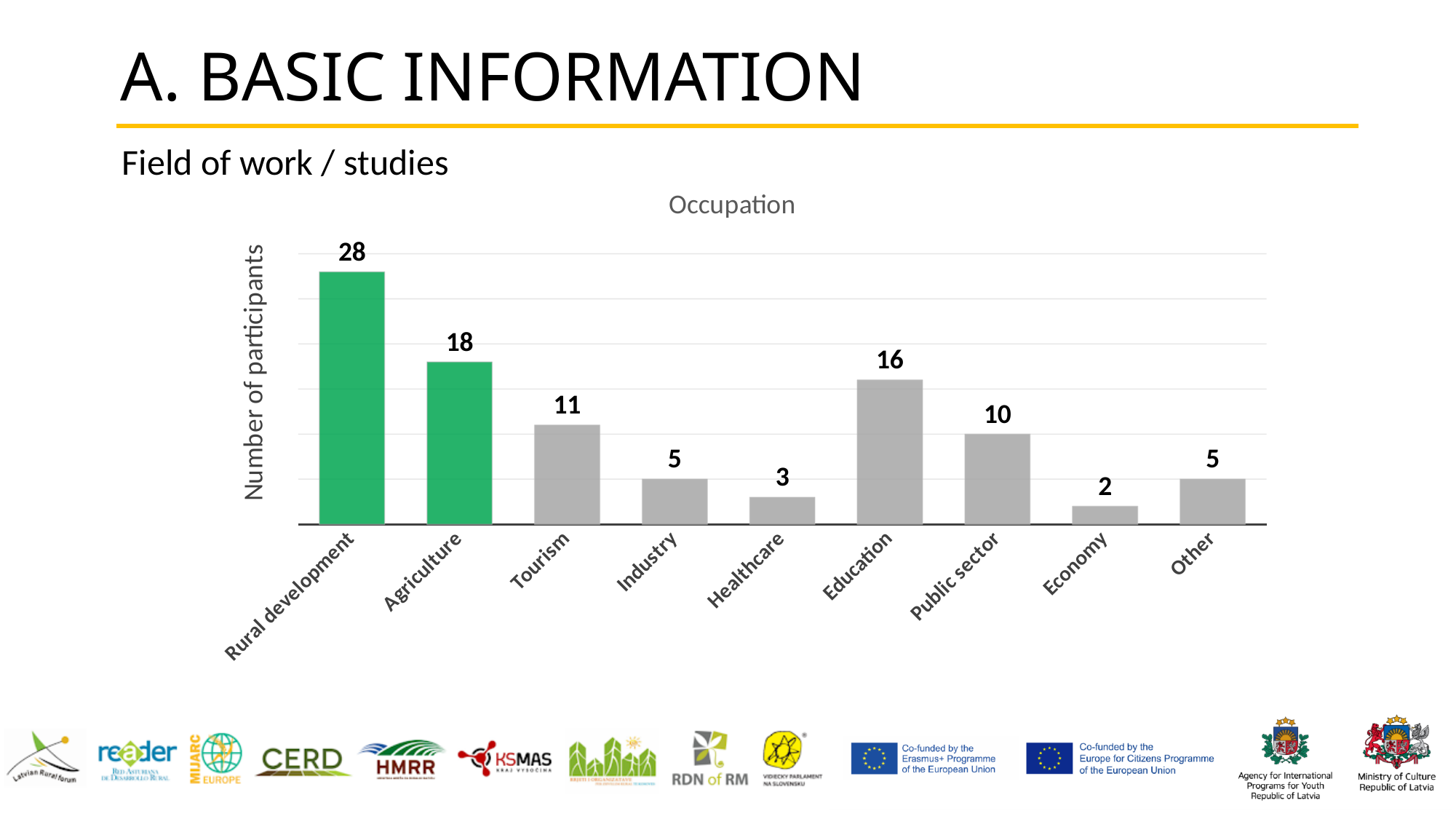
What is the difference in number of participants between Rural development and Agriculture? 10 Which occupation has the highest number of participants? Rural development Which occupation has the lowest number of participants? Economy What is the difference in number of participants between Education and Industry? 11 What kind of chart is shown on the slide? Bar chart What is the number of participants for Healthcare? 3 What is the title of the chart? Occupation What is the number of participants for Rural development? 28 Which has more participants, Tourism or Public sector? Tourism Which two bars are coloured green? Rural development and Agriculture What is the number of participants for Education? 16 How many occupation categories are shown in the chart? 9